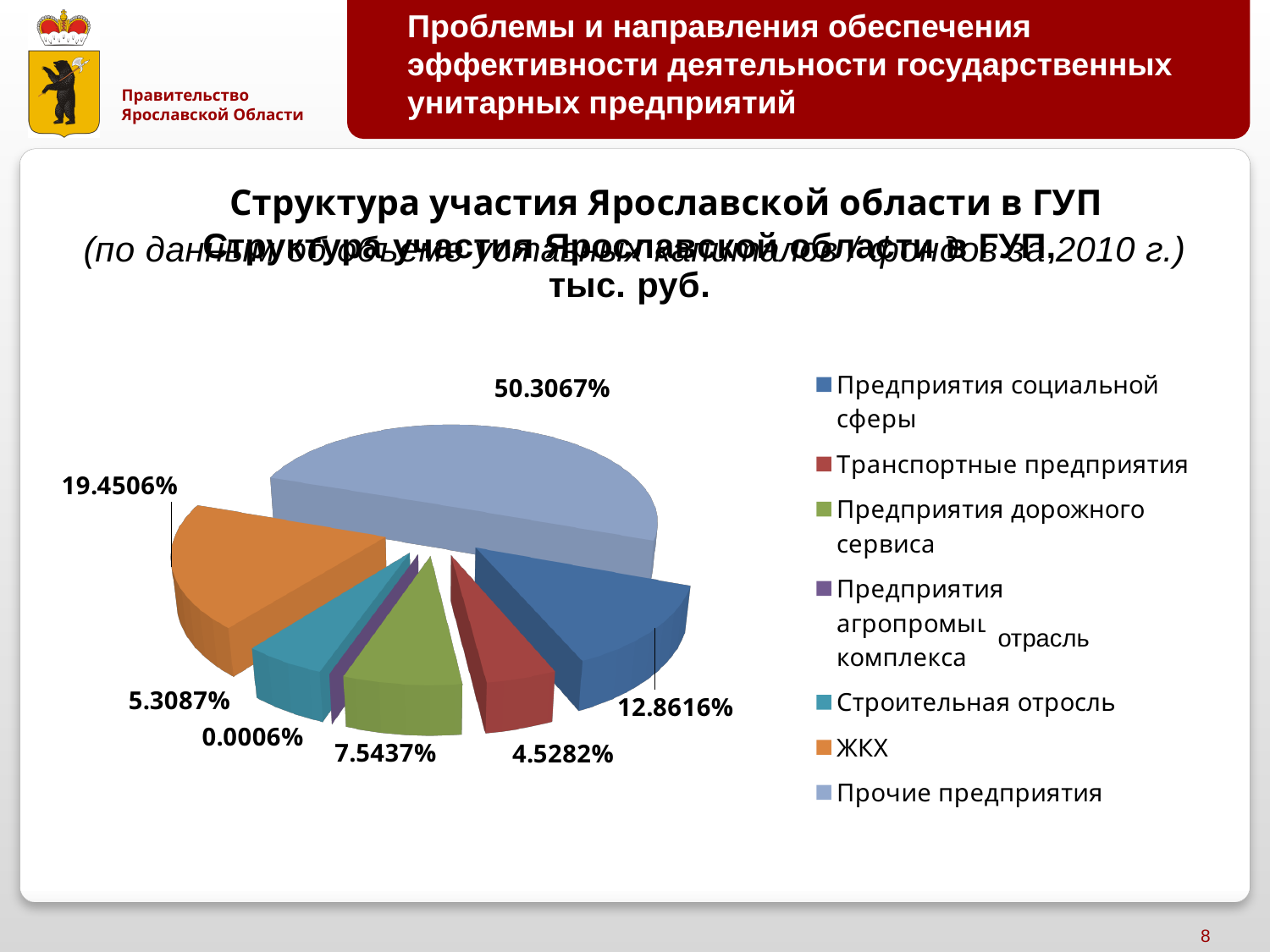
Which slice is larger: Предприятия дорожного сервиса or Транспортные предприятия? Предприятия дорожного сервиса What share of the pie is labelled for ЖКХ? 19.4506% What share of the pie is labelled for Предприятия социальной сферы? 12.8616% Which category has the smallest slice of the pie? Предприятия агропромышленного комплекса What kind of chart is shown on the slide? pie chart How many slices does the pie chart have? 7 What share of the pie is labelled for Транспортные предприятия? 4.5282% Which category has the largest slice of the pie? Прочие предприятия What share of the pie is labelled for Строительная отрасль? 5.3087% What is the difference between the shares of ЖКХ and Предприятия социальной сферы? 6.5890% How many entries does the legend of the pie chart list? 7 What share of the pie is labelled for Прочие предприятия? 50.3067%